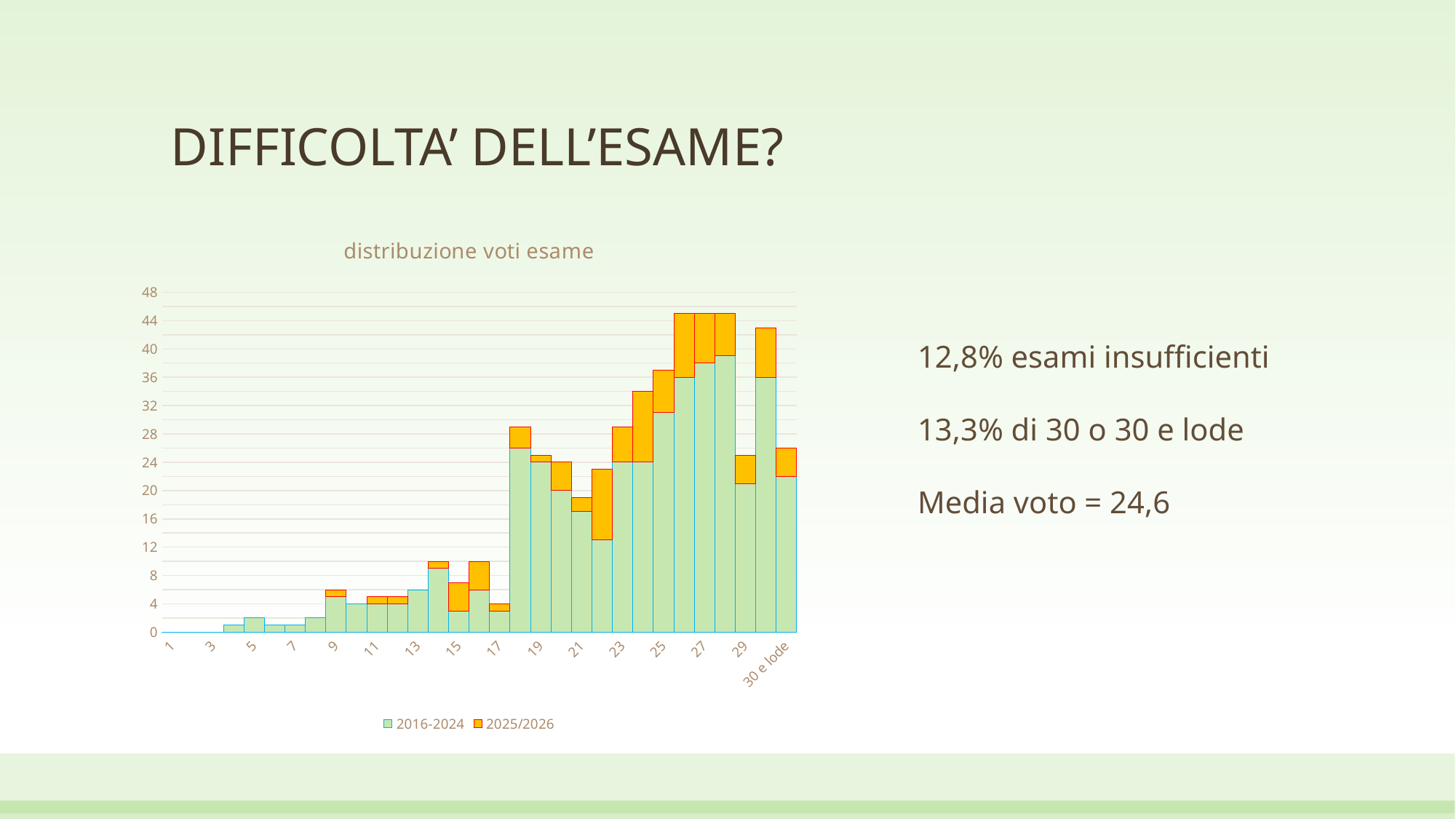
Is the total bar height for grade 17 greater or less than 8? less What kind of chart is shown on the slide? bar chart Which two series are listed in the chart legend? 2016-2024 and 2025/2026 Is the total bar height for grade 21 greater or less than 24? less What is the title of the chart? distribuzione voti esame Between grades 23 and 28, do the total bar heights generally rise or fall? rise Is the total bar height for grade 18 greater or less than 24? greater How many series does the chart legend list? 2 Which has the taller total bar, grade 18 or grade 19? 18 Which has the taller total bar, grade 29 or grade 30? 30